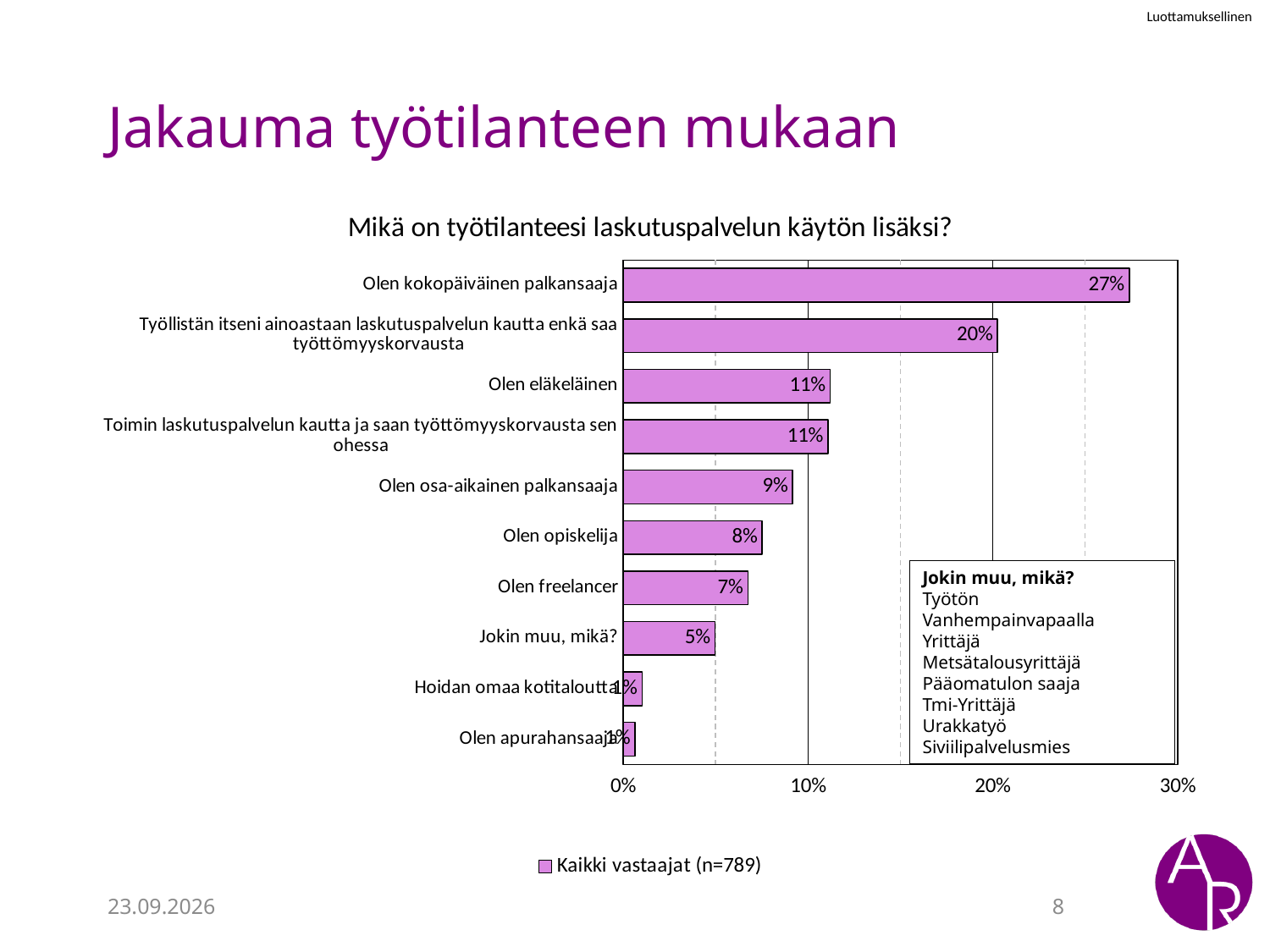
Which category has the highest value? Olen kokopäiväinen palkansaaja What is the difference between "Olen kokopäiväinen palkansaaja" and "Työllistän itseni ainoastaan laskutuspalvelun kautta enkä saa työttömyyskorvausta"? 7 percentage points What percentage of respondents answered "Olen kokopäiväinen palkansaaja"? 27% What is the value for "Olen opiskelija"? 8% What is the legend entry of the chart? Kaikki vastaajat (n=789) Is the value for "Olen eläkeläinen" greater or less than 10%? greater How many categories are shown in the chart? 10 How many series does the legend list? 1 What is the value for "Jokin muu, mikä?"? 5% Which is larger, the value for "Olen osa-aikainen palkansaaja" or the value for "Olen opiskelija"? Olen osa-aikainen palkansaaja What kind of chart is shown on the slide? bar chart What is the value for "Olen freelancer"? 7%